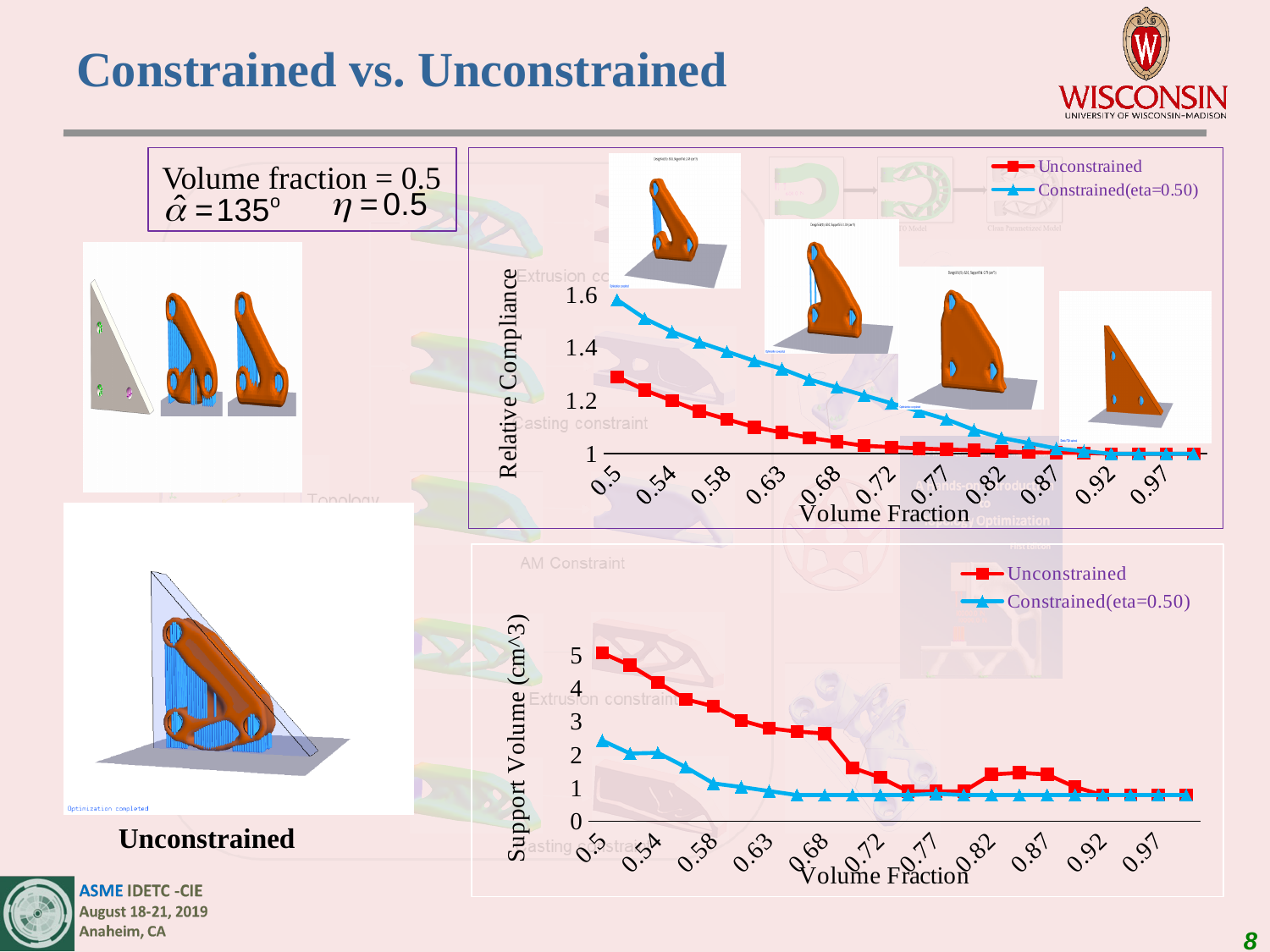
How many Volume Fraction tick labels are shown on the x axis of the bottom chart? 11 In the top chart, is the Relative Compliance of the Unconstrained series at Volume Fraction 0.5 greater or less than 1.4? less In the top chart, do the Relative Compliance values rise or fall as Volume Fraction increases? fall What kind of chart is the top chart (Relative Compliance vs. Volume Fraction)? line chart In the bottom chart, what are the two series named in the legend? Unconstrained and Constrained(eta=0.50) In the bottom chart, is the Support Volume of the Unconstrained series at Volume Fraction 0.5 greater or less than 4? greater In the bottom chart, which series has the higher Support Volume at Volume Fraction 0.5? Unconstrained What kind of chart is the bottom chart (Support Volume vs. Volume Fraction)? line chart How many series does the legend of the top chart list? 2 In the top chart, which series has the higher Relative Compliance at Volume Fraction 0.5? Constrained(eta=0.50) What is the y-axis title of the bottom chart? Support Volume (cm^3) In the top chart, is the Relative Compliance of the Constrained(eta=0.50) series at Volume Fraction 0.5 greater or less than 1.4? greater